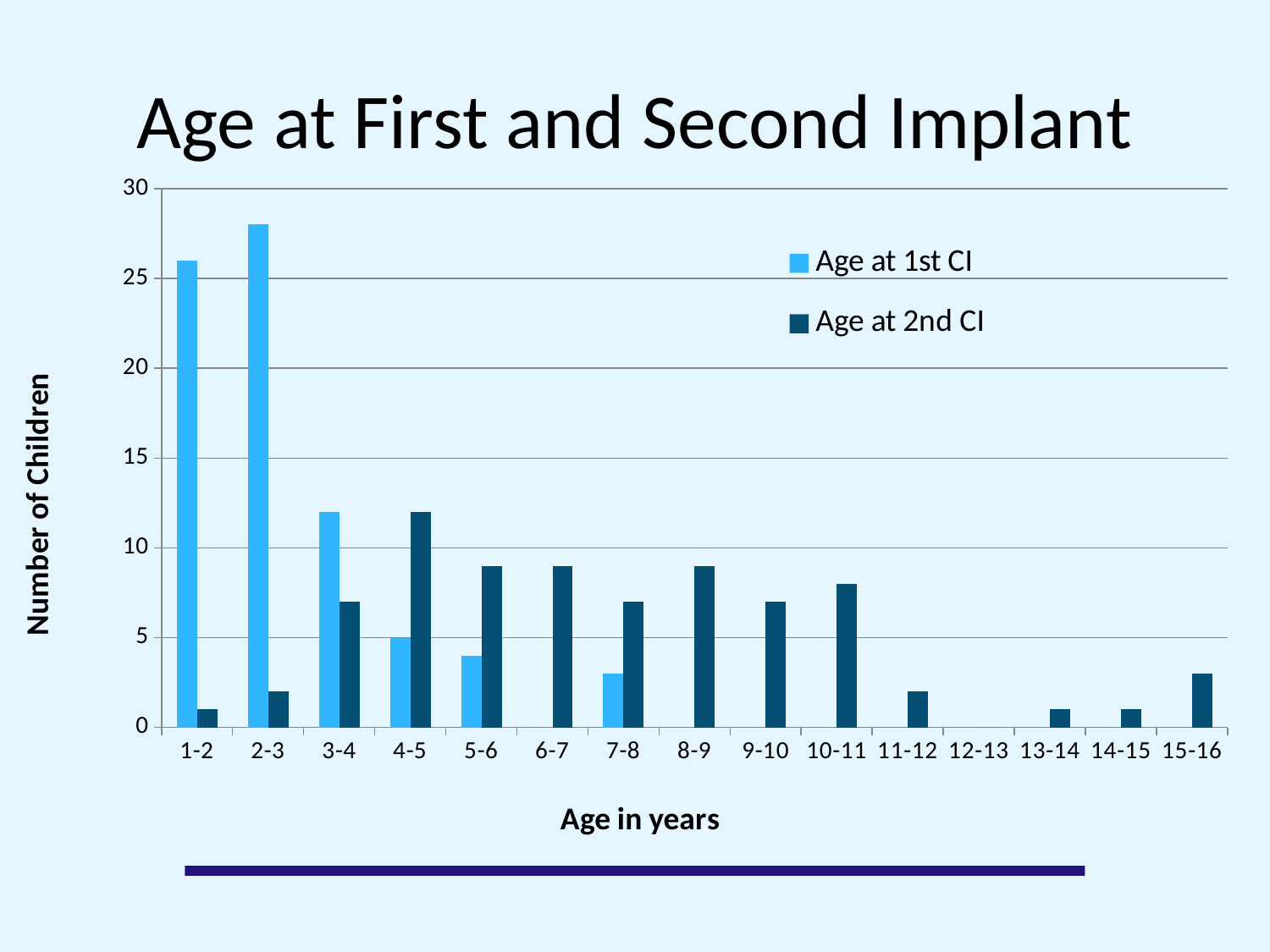
Is the value for Age at 1st CI in the 1-2 category greater or less than 25? greater In the 1-2 category, which series has the larger value, Age at 1st CI or Age at 2nd CI? Age at 1st CI What is the label of the vertical axis? Number of Children Is the value for Age at 2nd CI in the 15-16 category greater or less than 5? less How many series does the legend list? 2 How many age categories are shown on the x axis? 15 Which age category has the highest value for Age at 1st CI? 2-3 What kind of chart is shown on the slide? Bar chart In the 4-5 category, which series has the larger value, Age at 1st CI or Age at 2nd CI? Age at 2nd CI Is the value for Age at 2nd CI in the 4-5 category greater or less than 10? greater Which age category has the highest value for Age at 2nd CI? 4-5